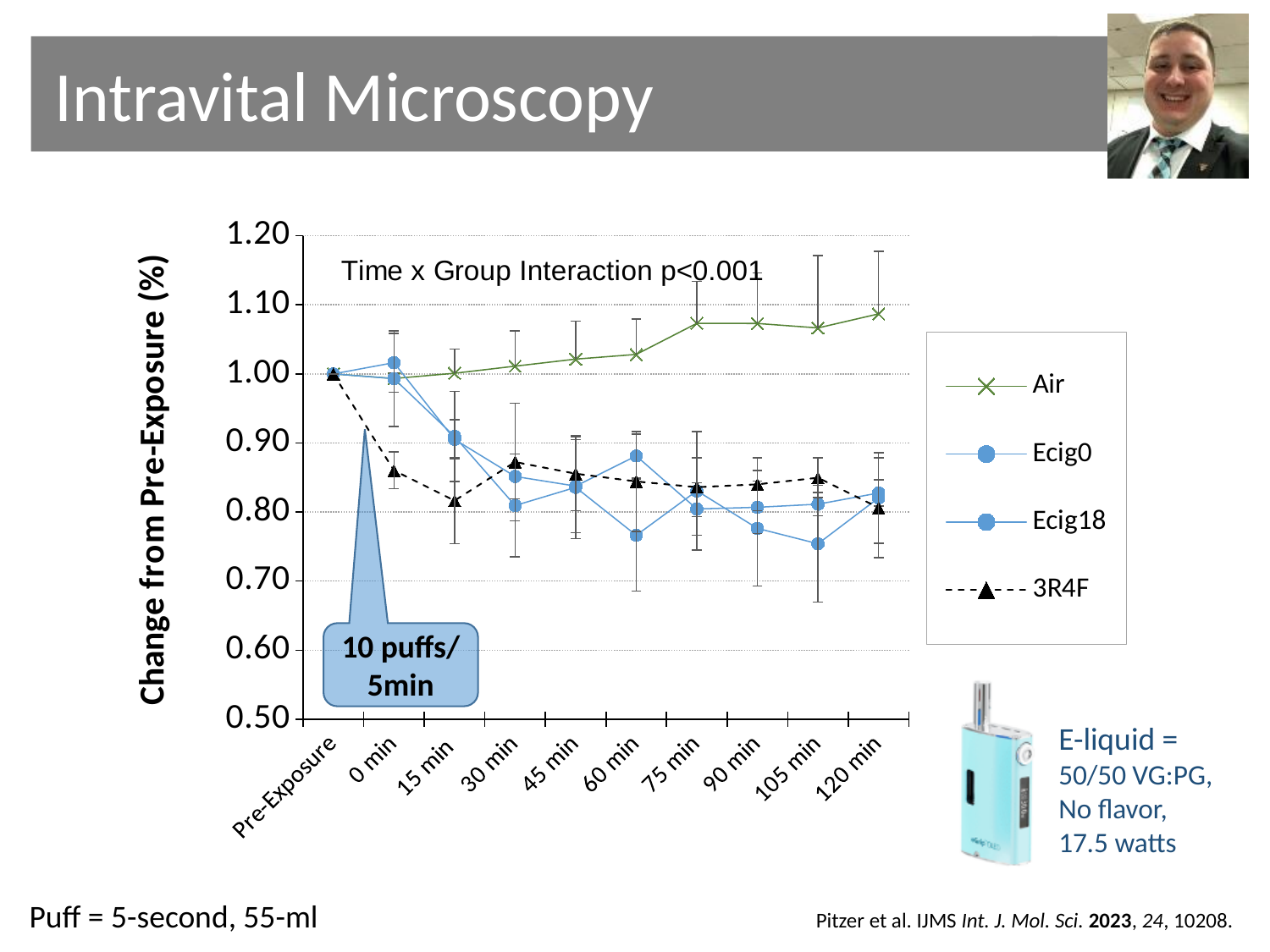
Which series has the highest value at 120 min? Air Is the value for 3R4F at 15 min greater or less than 0.90? less What kind of chart is shown on the slide? line chart How many series does the legend list? 4 At 75 min, which is larger, the value for Air or the value for 3R4F? Air Which series are listed in the legend? Air, Ecig0, Ecig18, 3R4F How many time points are shown along the x axis? 10 What statistical result is annotated at the top of the chart? Time x Group Interaction p<0.001 Is the value for Air at 120 min greater or less than 1.00? greater Does the Air series rise or fall from Pre-Exposure to 120 min? rise